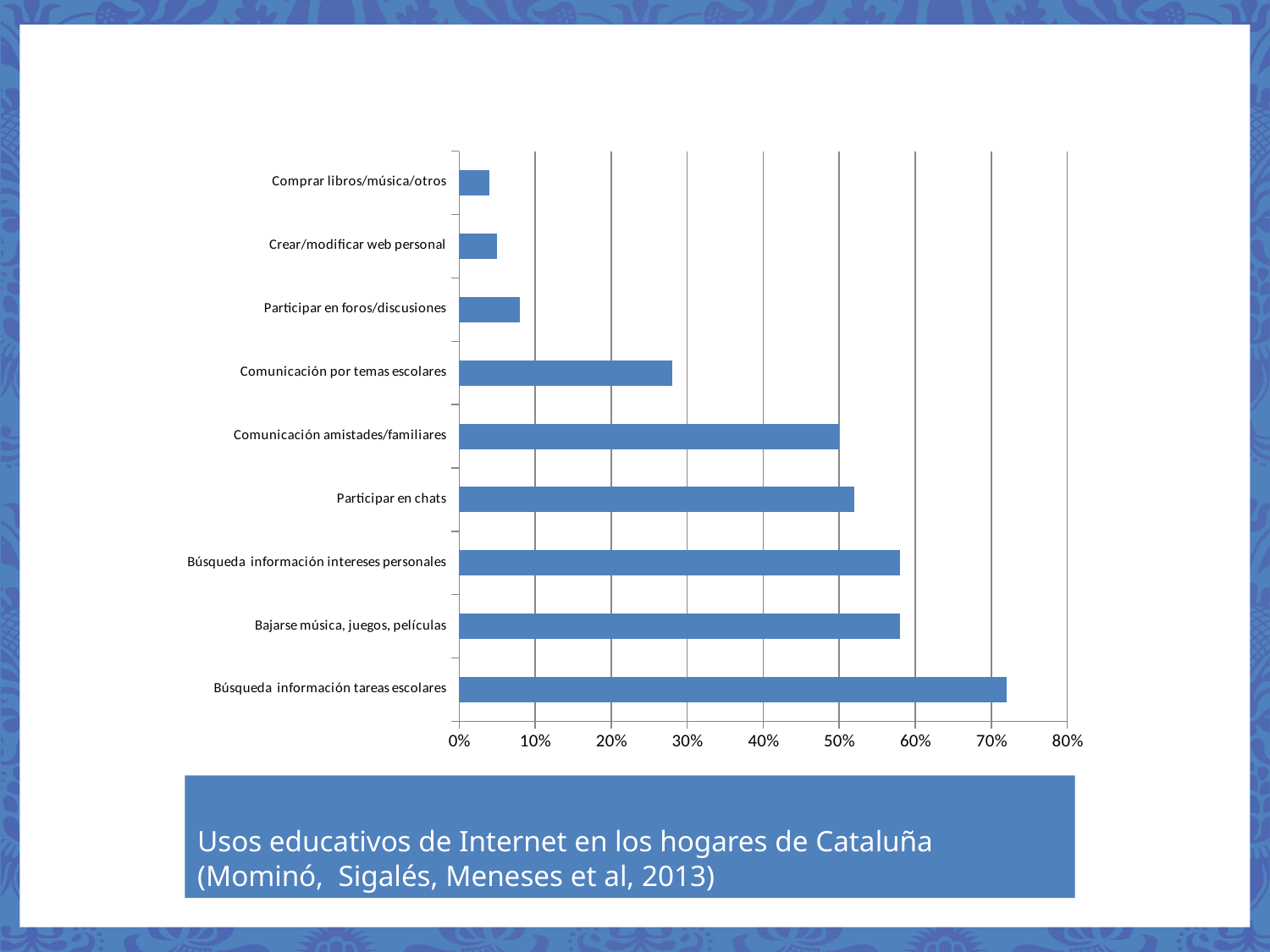
What is the caption text shown below the chart? Usos educativos de Internet en los hogares de Cataluña (Mominó, Sigalés, Meneses et al, 2013) Is the value for Búsqueda información tareas escolares greater or less than 60%? greater What kind of chart is shown on the slide? bar chart Is the value for Bajarse música, juegos, películas greater or less than 50%? greater Is the value for Participar en foros/discusiones greater or less than 10%? less Which is larger, the value for Participar en chats or the value for Participar en foros/discusiones? Participar en chats How many categories are plotted in the chart? 9 Which category has the highest value in the chart? Búsqueda información tareas escolares Which is larger, the value for Comunicación por temas escolares or the value for Comunicación amistades/familiares? Comunicación amistades/familiares